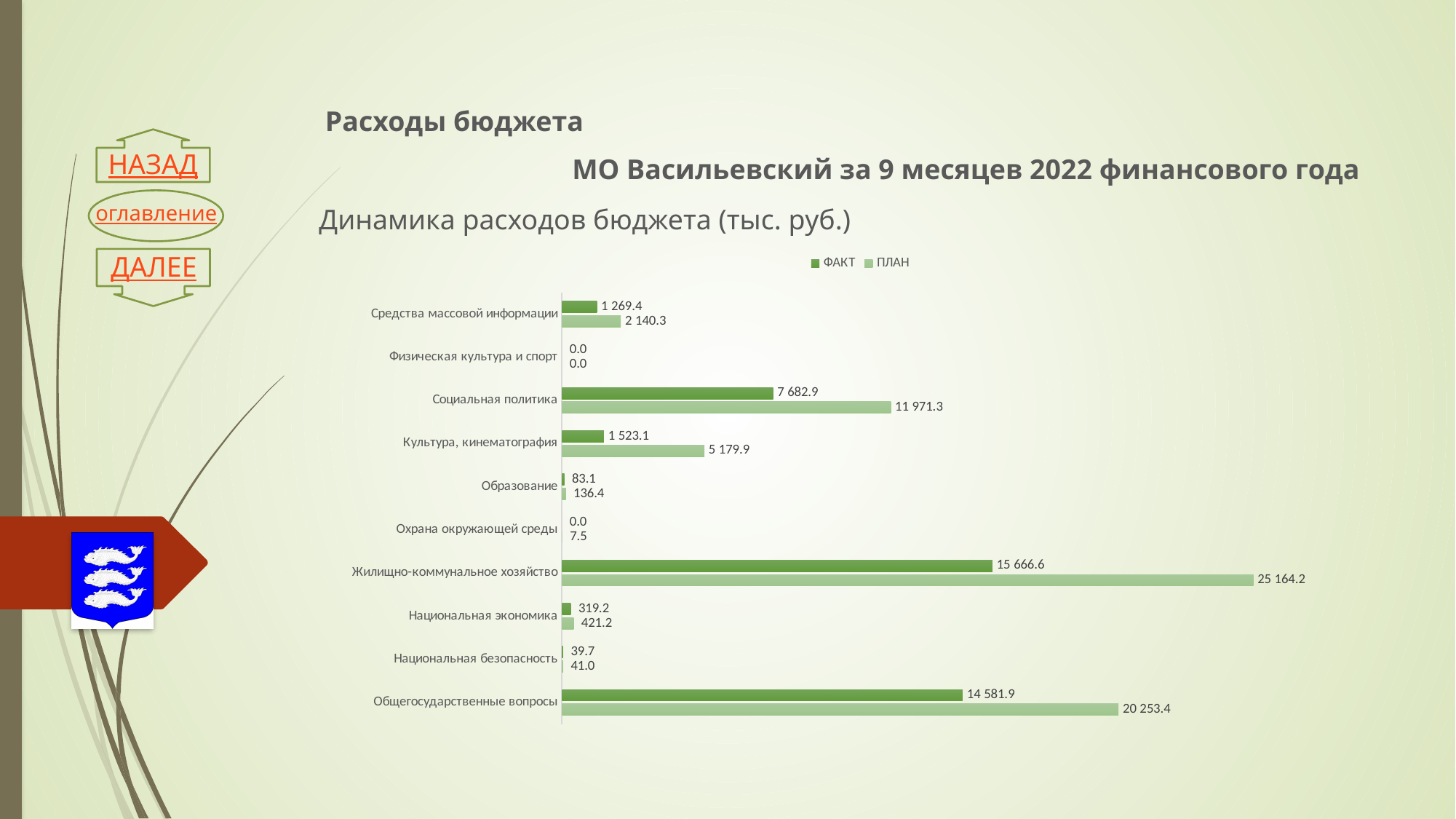
What is the ПЛАН value for Культура, кинематография? 5 179.9 How many categories are shown on the chart? 10 How many series does the legend list? 2 What is the ФАКТ value for Национальная безопасность? 39.7 What is the ФАКТ value for Жилищно-коммунальное хозяйство? 15 666.6 What is the difference between the ПЛАН and ФАКТ values for Жилищно-коммунальное хозяйство? 9 497.6 Which category has the highest ПЛАН value? Жилищно-коммунальное хозяйство What are the two series named in the legend? ФАКТ and ПЛАН What type of chart is shown on the slide? bar chart Which is larger: the ФАКТ value for Социальная политика or the ФАКТ value for Культура, кинематография? Социальная политика What is the difference between the ПЛАН and ФАКТ values for Общегосударственные вопросы? 5 671.5 What is the ПЛАН value for Социальная политика? 11 971.3